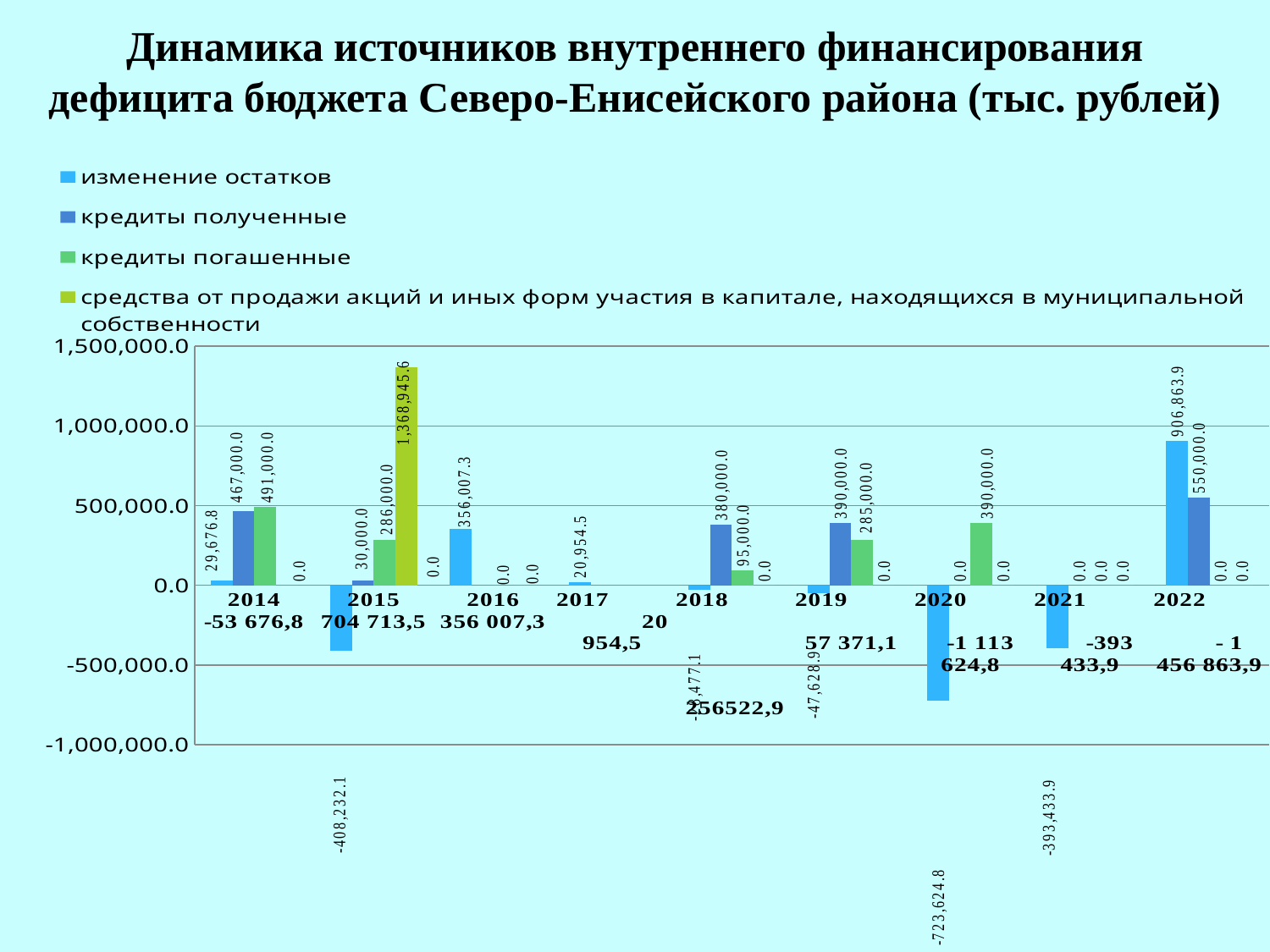
What is the value of средства от продажи акций и иных форм участия в капитале in 2015? 1,368,945.6 What kind of chart is shown on the slide? bar chart What is the value of изменение остатков in 2022? 906,863.9 What is the difference between кредиты полученные and кредиты погашенные in 2019? 105,000.0 Is the value of изменение остатков in 2016 greater or less than 500,000.0? less In 2014, which is larger: кредиты полученные or кредиты погашенные? кредиты погашенные How many series does the legend list? 4 What is the value of кредиты погашенные in 2020? 390,000.0 In which year is кредиты полученные the highest? 2022 In which year is изменение остатков the lowest? 2020 What is the value of кредиты полученные in 2014? 467,000.0 How many years are shown on the x axis? 9